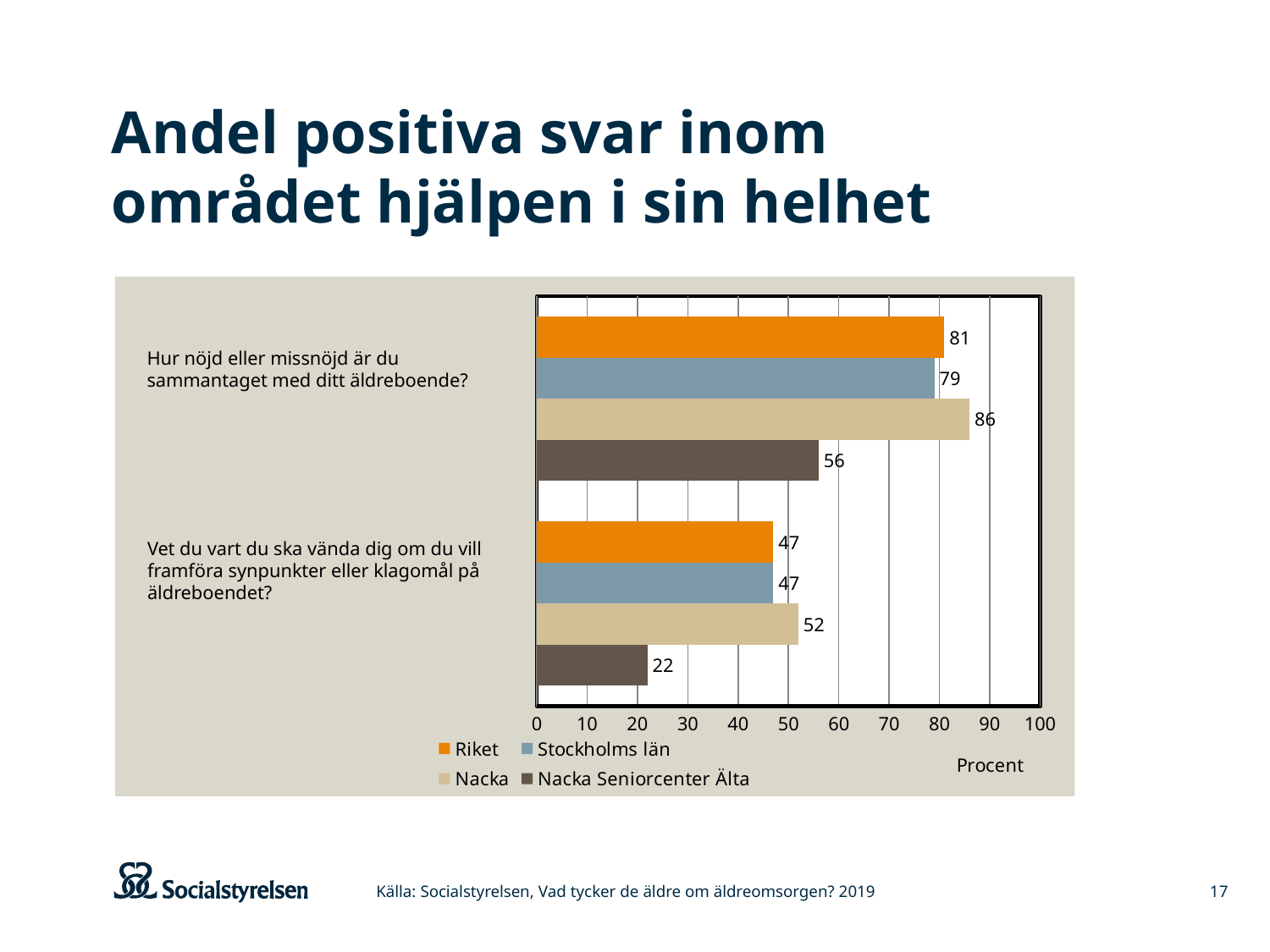
Which is larger on the question "Hur nöjd eller missnöjd är du sammantaget med ditt äldreboende?": the value for Riket or the value for Stockholms län? Riket What is the value for Riket on the question "Vet du vart du ska vända dig om du vill framföra synpunkter eller klagomål på äldreboendet?"? 47 What is the value for Nacka on the question "Hur nöjd eller missnöjd är du sammantaget med ditt äldreboende?"? 86 How many series does the legend list? 4 How many questions (categories) are shown on the chart? 2 Which series has the highest value on the question "Hur nöjd eller missnöjd är du sammantaget med ditt äldreboende?"? Nacka What is the value for Stockholms län on the question "Hur nöjd eller missnöjd är du sammantaget med ditt äldreboende?"? 79 Which series has the lowest value on the question "Vet du vart du ska vända dig om du vill framföra synpunkter eller klagomål på äldreboendet?"? Nacka Seniorcenter Älta What is the difference between the Nacka value and the Nacka Seniorcenter Älta value on the question "Hur nöjd eller missnöjd är du sammantaget med ditt äldreboende?"? 30 What kind of chart is shown on the slide? Bar chart What unit is shown on the horizontal axis of the chart? Procent What is the value for Nacka Seniorcenter Älta on the question "Vet du vart du ska vända dig om du vill framföra synpunkter eller klagomål på äldreboendet?"? 22